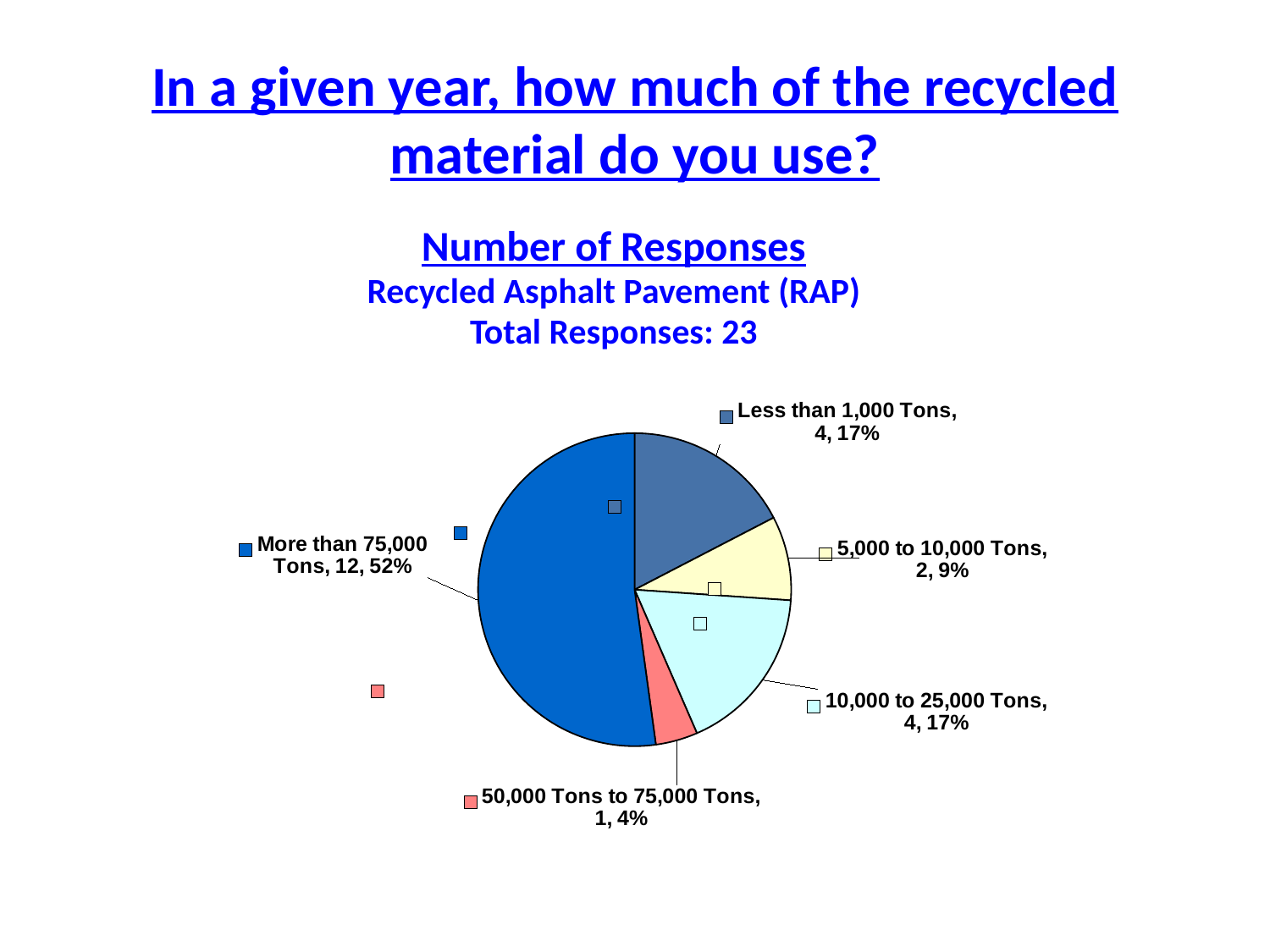
How many responses are in the 'More than 75,000 Tons' category? 12 How many categories (slices) does the pie chart have? 5 Which has more responses: '5,000 to 10,000 Tons' or '10,000 to 25,000 Tons'? 10,000 to 25,000 Tons Which recycled material does the chart cover? Recycled Asphalt Pavement (RAP) What percentage share does the 'Less than 1,000 Tons' slice represent? 17% What percentage share does the '50,000 Tons to 75,000 Tons' slice represent? 4% How many responses are in the '5,000 to 10,000 Tons' category? 2 What is the total number of responses shown on the slide? 23 Which category has the largest number of responses? More than 75,000 Tons What kind of chart is shown on the slide? Pie chart What is the difference in responses between 'More than 75,000 Tons' and '10,000 to 25,000 Tons'? 8 Which category has the smallest number of responses? 50,000 Tons to 75,000 Tons